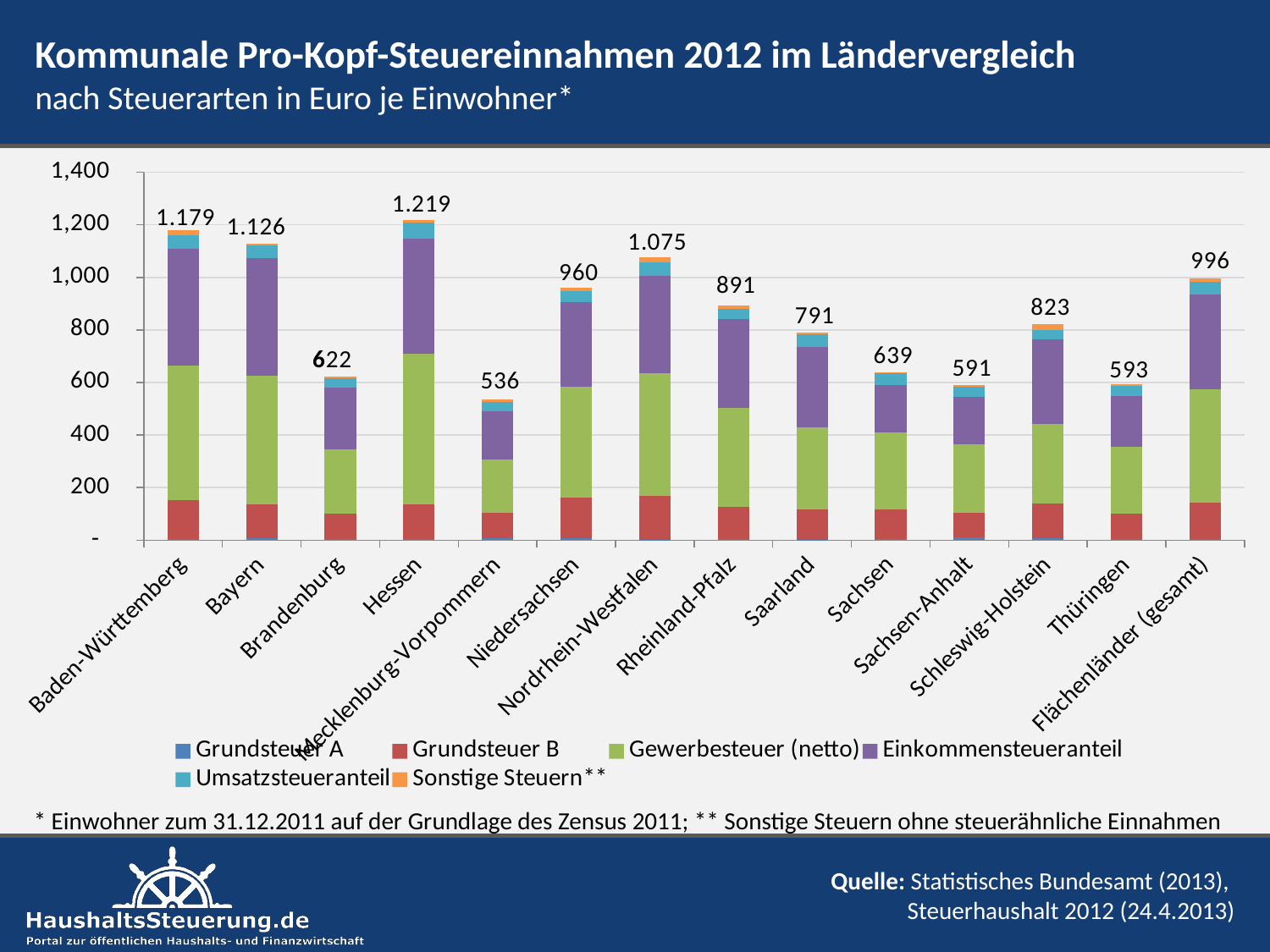
What kind of chart is shown on the slide? Stacked bar chart Is the total for Saarland greater or less than 800? less What is the difference between the totals for Hessen and Mecklenburg-Vorpommern? 683 What is the total per-capita tax revenue shown for Hessen? 1.219 How many categories (Länder including the overall total) are shown on the x axis? 14 What is the difference between the totals for Baden-Württemberg and Bayern? 53 Which has the larger total, Sachsen or Thüringen? Sachsen How many series does the legend list? 6 Which Land has the lowest total per-capita tax revenue? Mecklenburg-Vorpommern What is the value shown for Flächenländer (gesamt)? 996 Which Land has the highest total per-capita tax revenue? Hessen What value is labelled for Nordrhein-Westfalen? 1.075